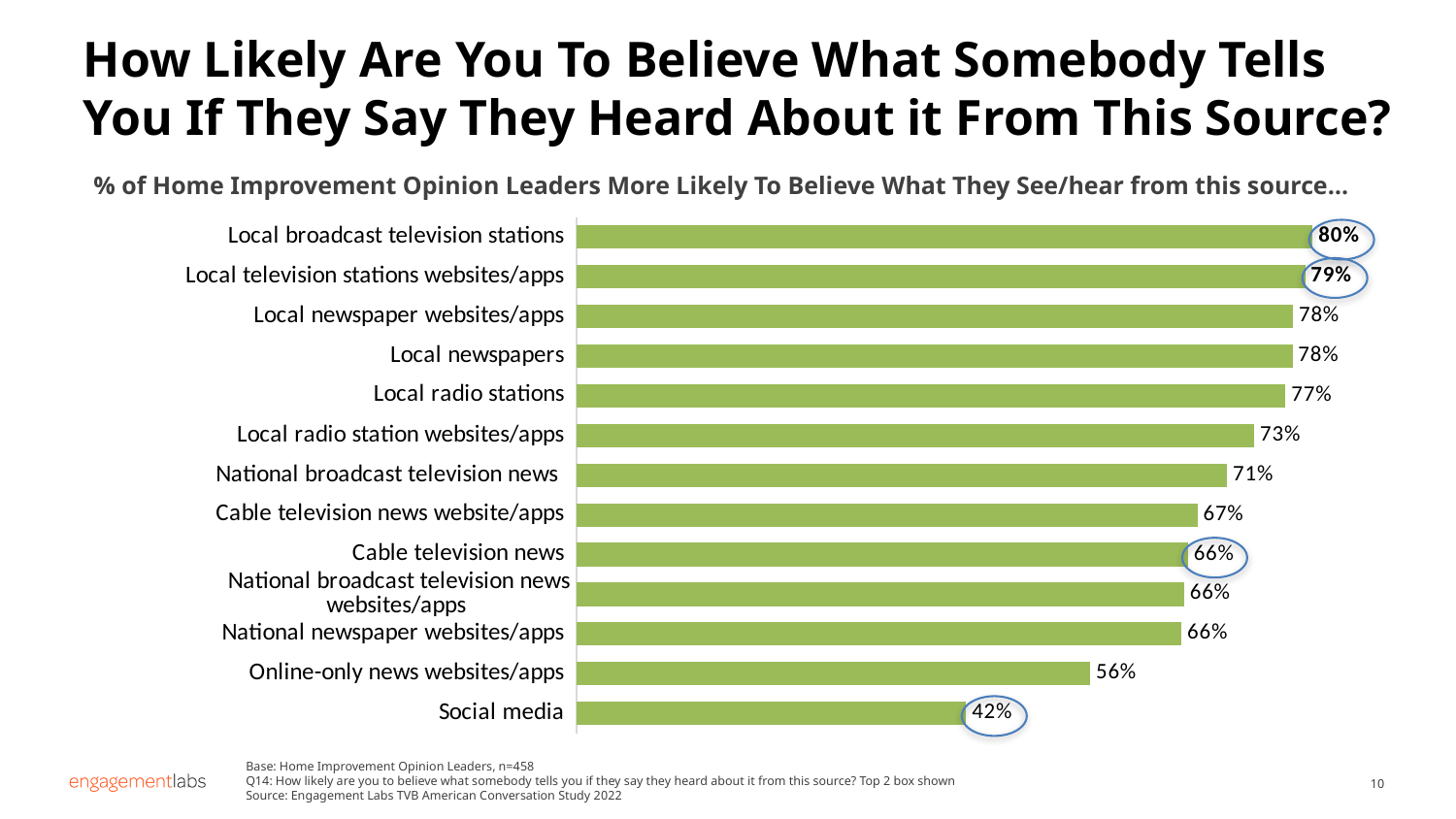
What colour are the bars in the chart? Green What is the difference between the values for National broadcast television news and Cable television news? 5 percentage points Which has a higher value, Local radio stations or Cable television news website/apps? Local radio stations What is the difference between the values for Local broadcast television stations and Social media? 38 percentage points What is the value shown for Social media? 42% Which source has the highest percentage? Local broadcast television stations What is the value shown for Online-only news websites/apps? 56% Which source has the lowest percentage? Social media What percentage of Home Improvement Opinion Leaders are more likely to believe what they hear from Local broadcast television stations? 80% How many sources are shown in the chart? 13 What kind of chart is shown on the slide? Bar chart What is the value shown for Local radio station websites/apps? 73%